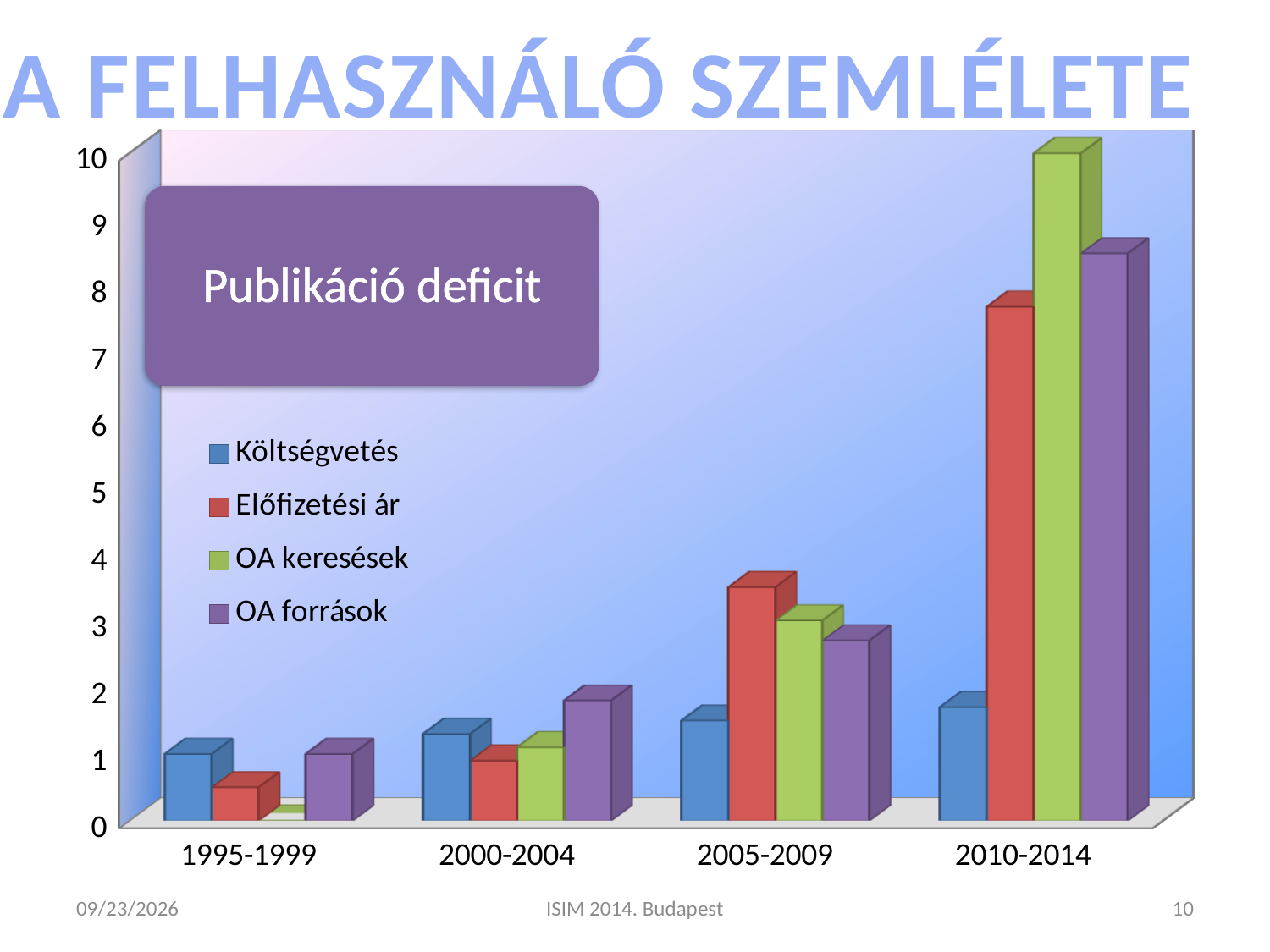
Do the values for OA keresések rise or fall from 1995-1999 to 2010-2014? rise How many series does the chart's legend list? 4 Is the value for Előfizetési ár in 2010-2014 greater or less than 7? greater What kind of chart is shown on the slide? bar chart Which series has the highest bar in the 2010-2014 period? OA keresések In the 2005-2009 period, which is larger: Előfizetési ár or Költségvetés? Előfizetési ár Is the value for Költségvetés in 2010-2014 greater or less than 2? less Is the value for OA keresések in 2010-2014 greater or less than 9? greater What text is shown in the purple box overlaid on the chart? Publikáció deficit Which series has the lowest bar in the 1995-1999 period? OA keresések Which series has the lowest bar in the 2010-2014 period? Költségvetés How many time periods are shown on the x axis of the chart? 4